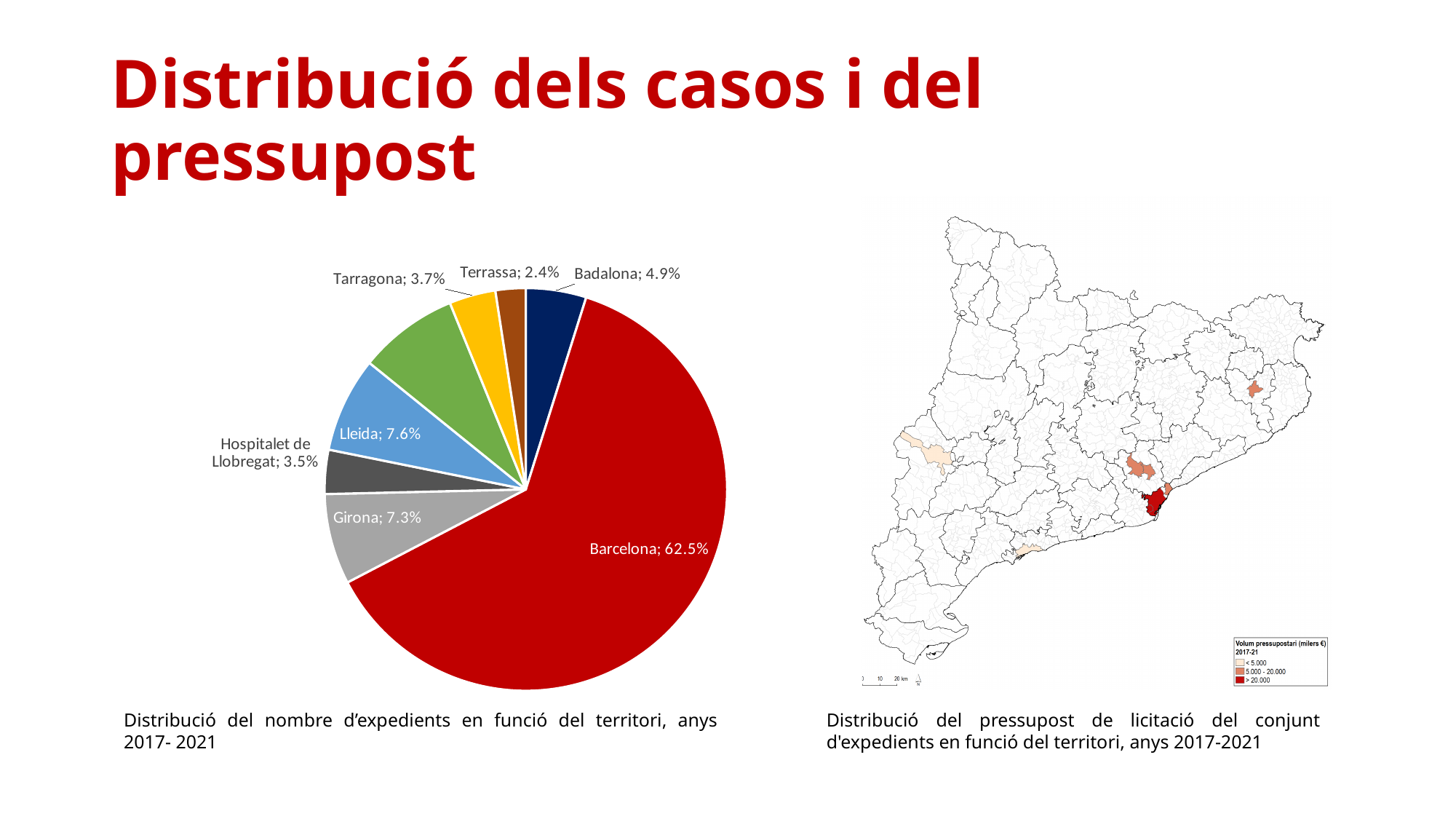
In the pie chart on the left, what colour is the Barcelona slice? Red How many slices does the pie chart on the left have? 8 In the pie chart on the left, what share of cases does Barcelona account for? 62.5% What type of chart is shown on the left of the slide? Pie chart In the pie chart on the left, which territory has the largest slice? Barcelona In the pie chart on the left, which is larger, the share for Lleida or the share for Girona? Lleida In the pie chart on the left, what is the combined share of Girona and Lleida? 14.9% In the pie chart on the left, what is the value shown for Lleida? 7.6% In the pie chart on the left, what is the difference in percentage points between Badalona and Tarragona? 1.2 In the pie chart on the left, what percentage is shown for Hospitalet de Llobregat? 3.5% In the pie chart on the left, what is the value for Terrassa? 2.4% In the pie chart on the left, which territory has the smallest slice? Terrassa